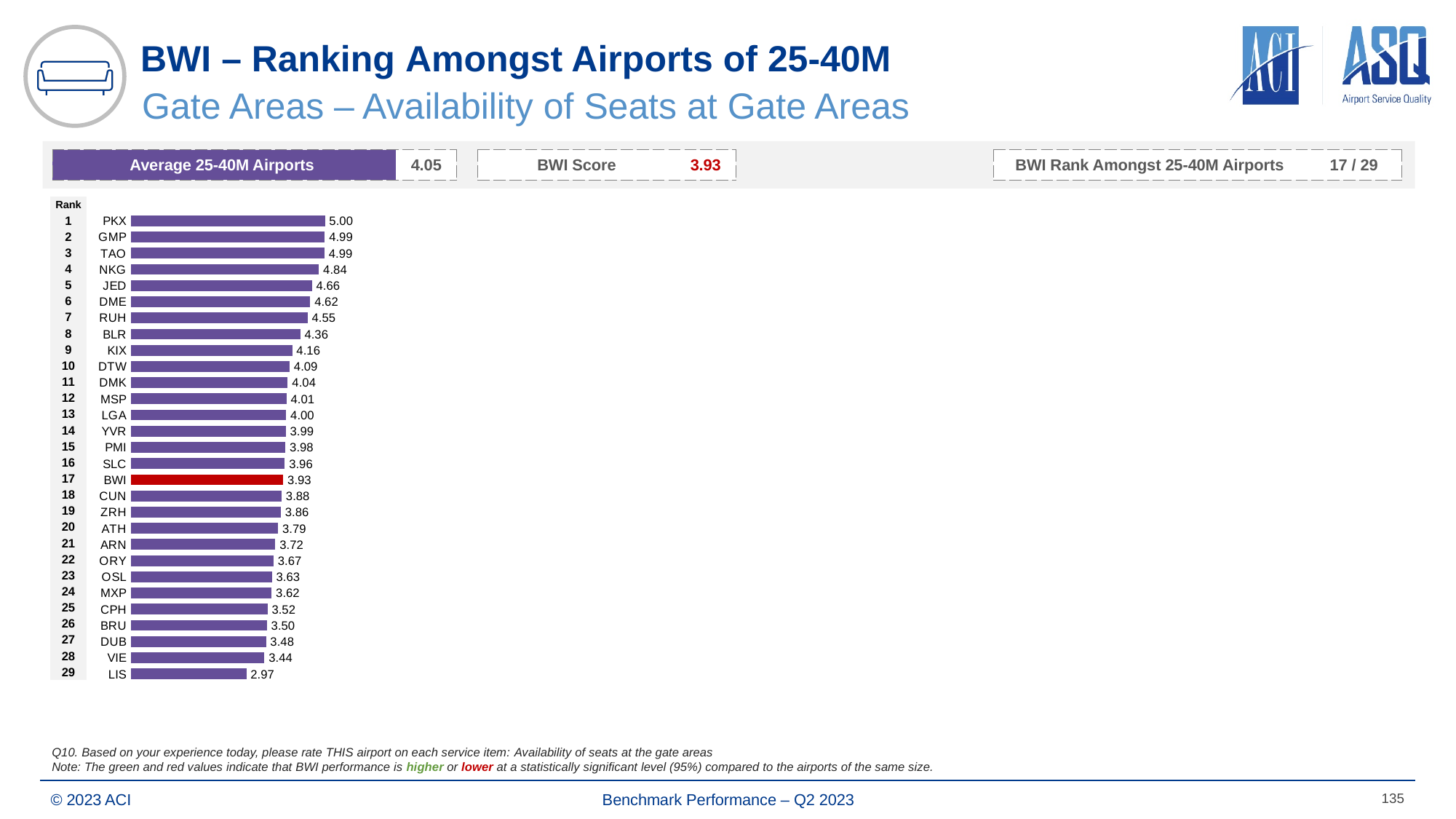
What is the score for BWI in the chart? 3.93 Which airport has the lowest score in the chart? LIS What is BWI's rank amongst 25-40M airports? 17 / 29 What is the score for PKX? 5.00 What is the score for LIS? 2.97 How many airports are ranked in the chart? 29 What is the difference between the scores of PKX and LIS? 2.03 Which bar in the chart is coloured red? BWI What kind of chart is shown on the slide? Bar chart What is the difference between the scores of BWI and CUN? 0.05 Which has a higher score, DTW or ORY? DTW Which airport has the highest score in the chart? PKX